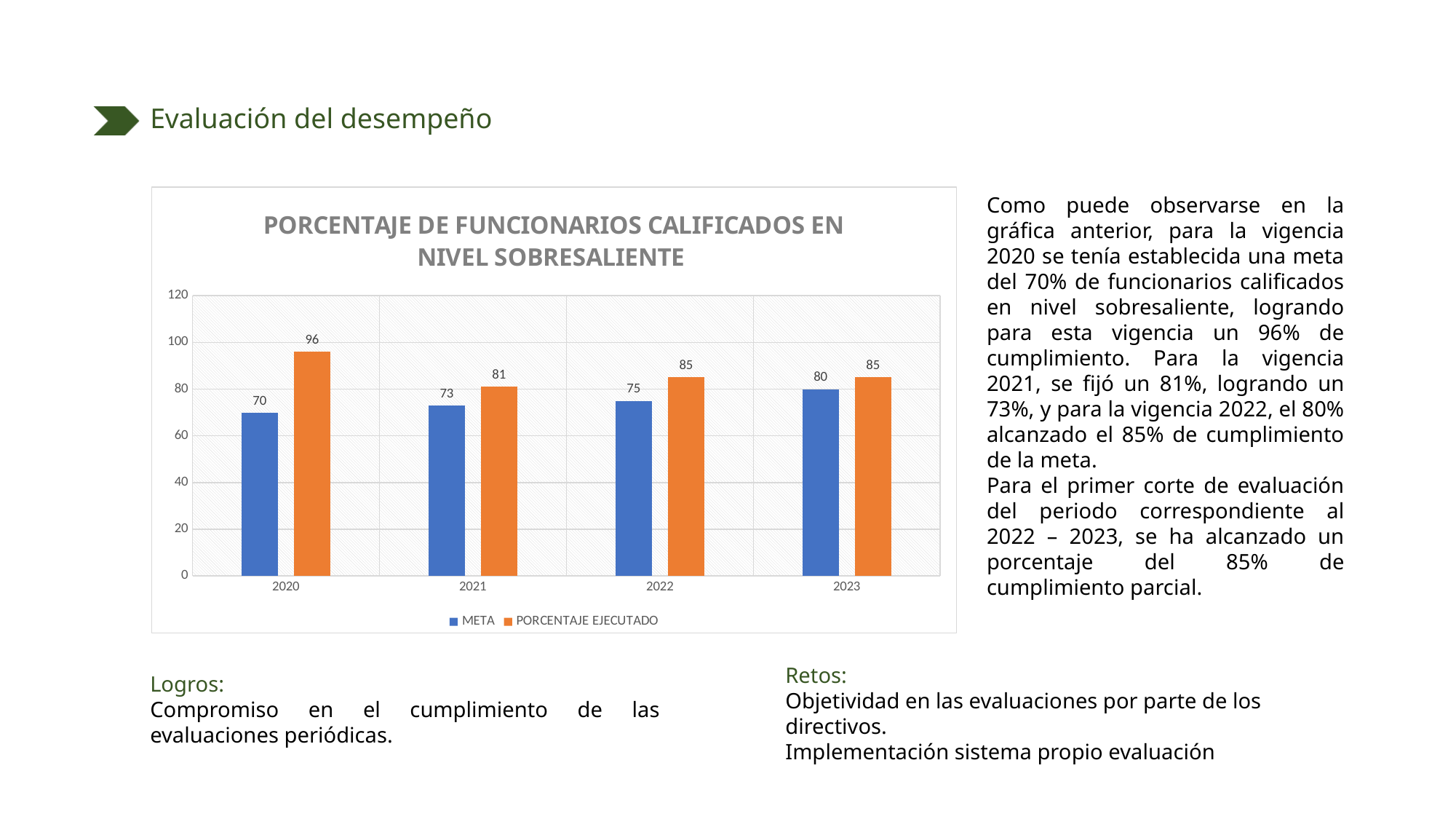
Which year has the highest PORCENTAJE EJECUTADO value? 2020 How many series does the legend list? 2 What kind of chart is shown? bar chart Do the META values rise or fall from 2020 to 2023? rise Which is larger in 2022, META or PORCENTAJE EJECUTADO? PORCENTAJE EJECUTADO Which year has the lowest META value? 2020 Is the PORCENTAJE EJECUTADO value for 2023 greater or less than 100? less How many years are shown on the x axis? 4 What is the META value for 2023? 80 What is the PORCENTAJE EJECUTADO value for 2021? 81 What is the difference between PORCENTAJE EJECUTADO and META in 2020? 26 What is the META value for 2020? 70